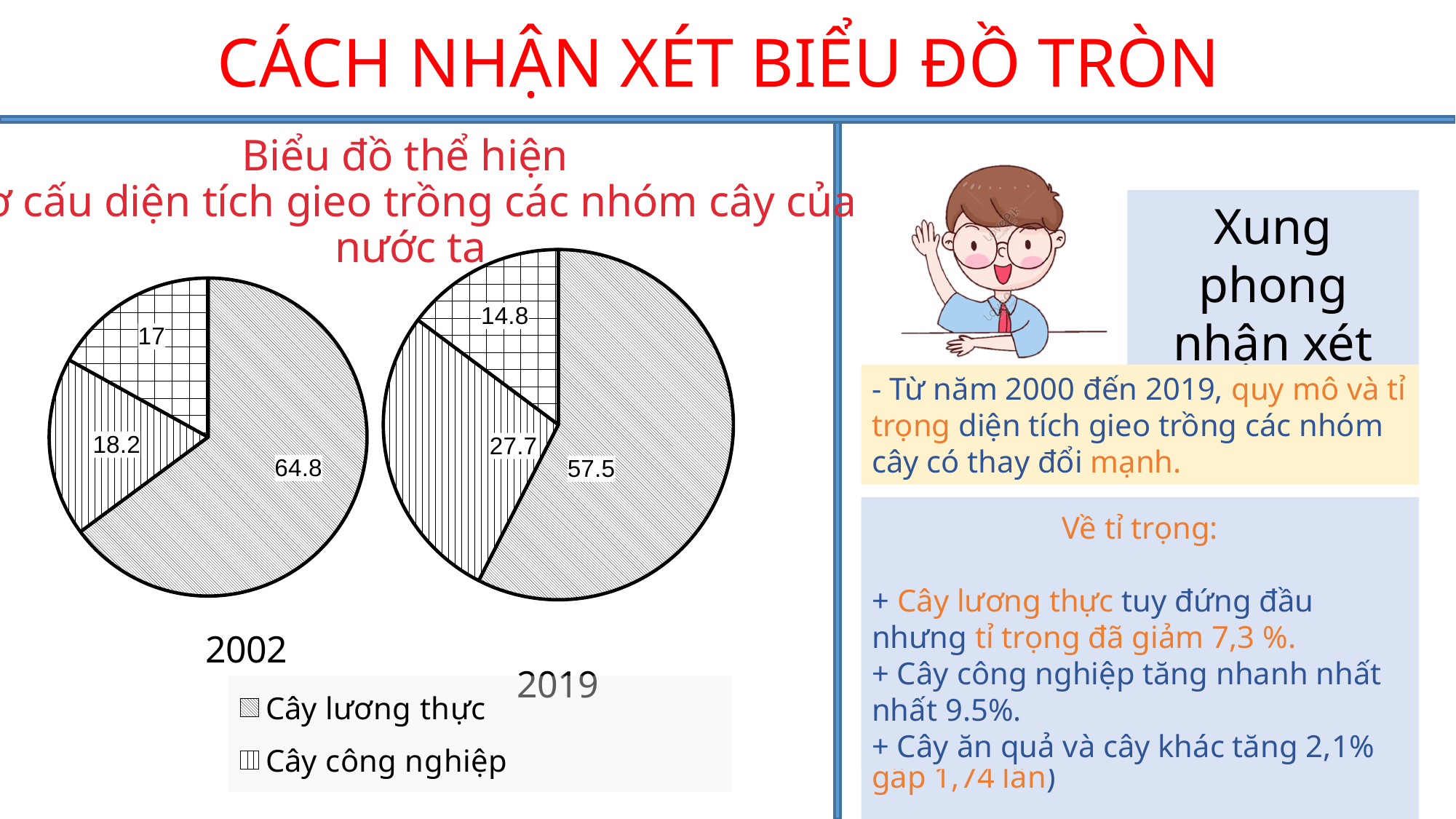
How many slices does the 2019 pie chart have? 3 Is the value for Cây công nghiệp larger in the 2002 pie chart or the 2019 pie chart? 2019 In the 2002 pie chart, what is the value for Cây lương thực? 64.8 In the 2002 pie chart, which category has the largest slice? Cây lương thực By how much did the value for Cây lương thực fall from the 2002 pie chart to the 2019 pie chart? 7.3 What is the smallest value labelled on the 2019 pie chart? 14.8 By how much did the value for Cây công nghiệp rise from the 2002 pie chart to the 2019 pie chart? 9.5 What kind of charts are shown on the slide? Pie charts How many entries does the legend list? 2 In the 2002 pie chart, what is the value for Cây công nghiệp? 18.2 In the 2019 pie chart, what is the value for Cây lương thực? 57.5 In the 2019 pie chart, what is the value for Cây công nghiệp? 27.7